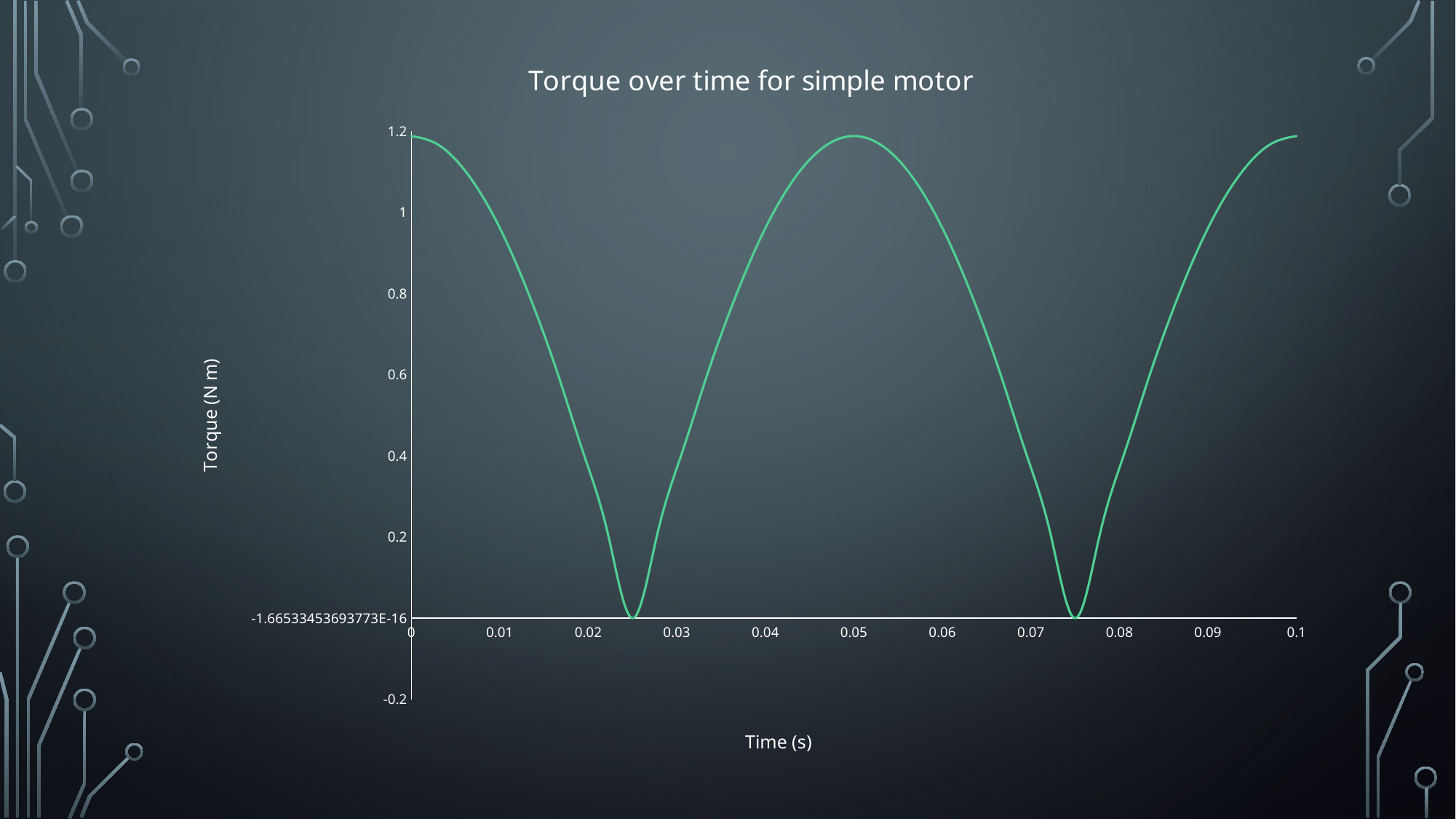
Does the torque rise or fall between time 0.025 s and 0.05 s? rise What is the title of the chart? Torque over time for simple motor Which is larger, the torque at 0.05 s or the torque at 0.075 s? 0.05 s Is the torque value at time 0.06 s greater or less than 0.8? greater Is the torque value at time 0.075 s greater or less than 0.2? less Is the torque value at time 0 s greater or less than 1? greater What is the label of the vertical axis? Torque (N m) What kind of chart is shown on the slide? line chart Does the torque rise or fall between time 0 s and 0.025 s? fall